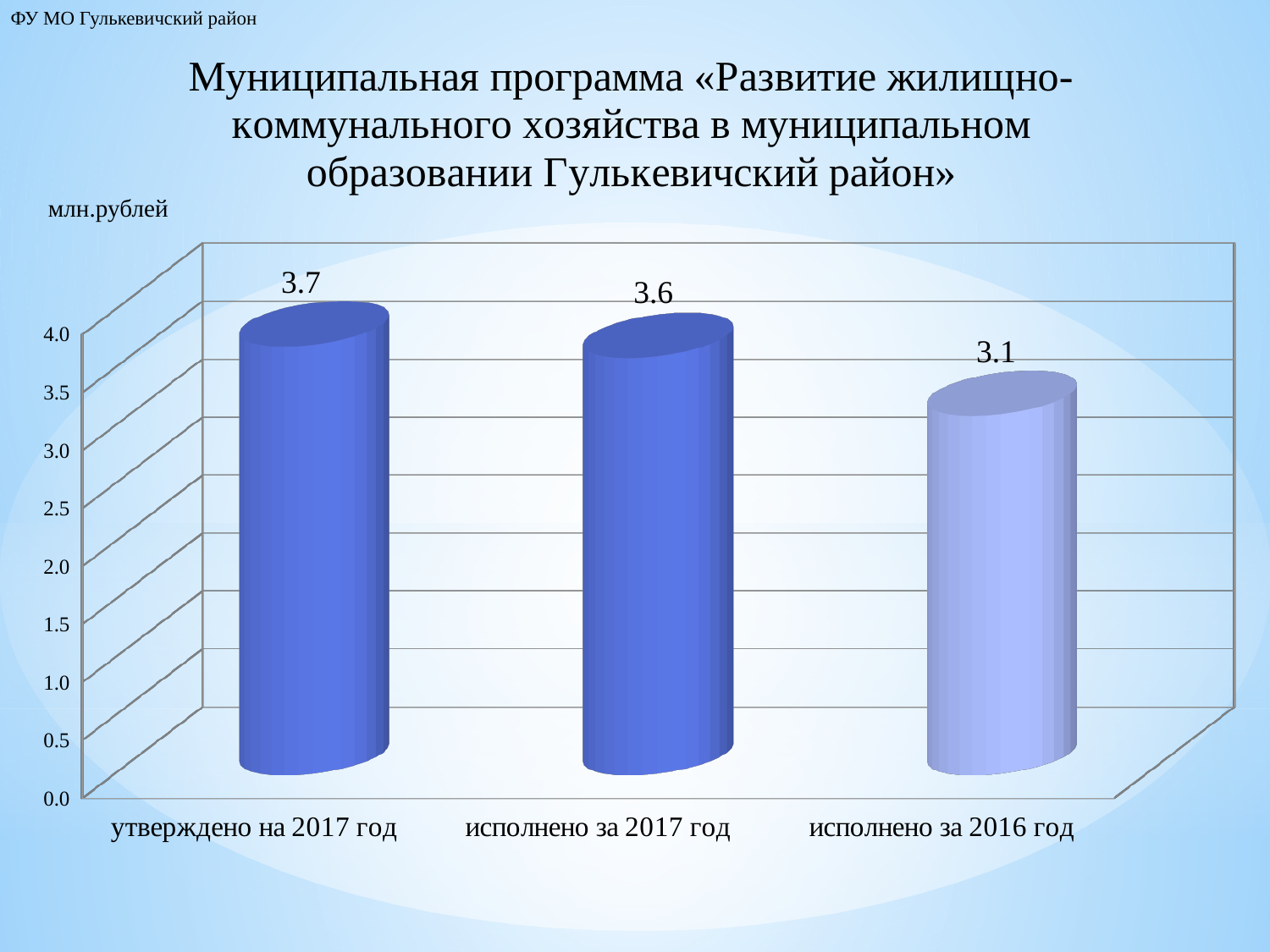
What is the difference between «исполнено за 2017 год» and «исполнено за 2016 год»? 0.5 Is the value for «исполнено за 2016 год» greater or less than 3.5? less Which category has the lowest value? исполнено за 2016 год What is the value for «исполнено за 2017 год»? 3.6 What is the difference between «утверждено на 2017 год» and «исполнено за 2017 год»? 0.1 What kind of chart is shown on the slide? bar chart What unit of measurement is indicated above the chart? млн.рублей Which is larger: «исполнено за 2017 год» or «исполнено за 2016 год»? исполнено за 2017 год What is the value for «утверждено на 2017 год»? 3.7 What is the value for «исполнено за 2016 год»? 3.1 How many categories are shown on the chart? 3 Which category has the highest value? утверждено на 2017 год